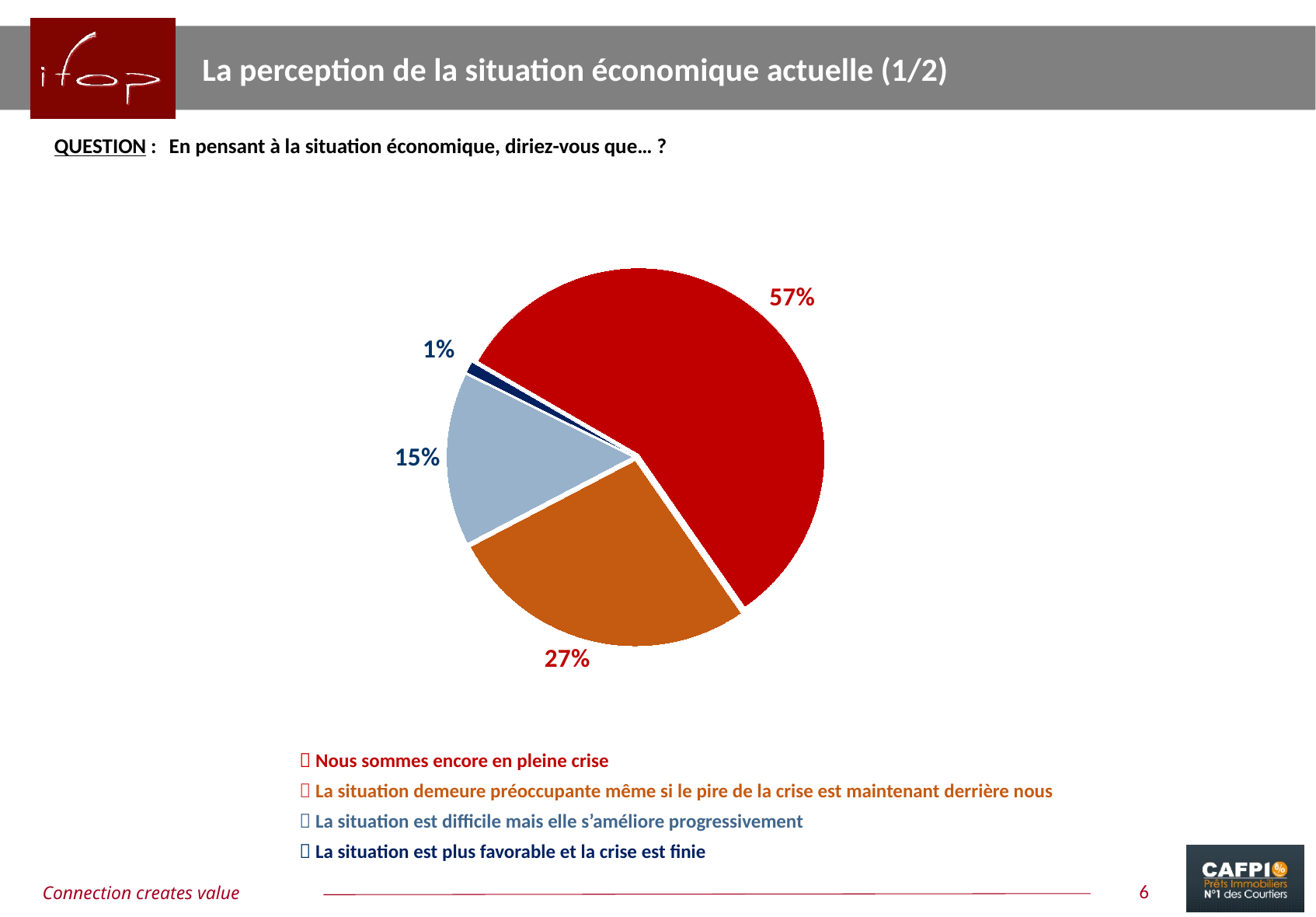
What share of respondents said "La situation demeure préoccupante même si le pire de la crise est maintenant derrière nous"? 27% What share of respondents said "La situation est difficile mais elle s'améliore progressivement"? 15% Which response has the largest slice of the pie? Nous sommes encore en pleine crise How many slices does the pie chart have? 4 Which response has the smallest slice of the pie? La situation est plus favorable et la crise est finie What share of respondents said "Nous sommes encore en pleine crise"? 57% What colour is the slice representing "Nous sommes encore en pleine crise"? red What is the difference in percentage points between "Nous sommes encore en pleine crise" and "La situation demeure préoccupante même si le pire de la crise est maintenant derrière nous"? 30 percentage points Which is larger: the share for "La situation est difficile mais elle s'améliore progressivement" or the share for "La situation demeure préoccupante même si le pire de la crise est maintenant derrière nous"? La situation demeure préoccupante même si le pire de la crise est maintenant derrière nous What kind of chart is shown on the slide? pie chart What share of respondents said "La situation est plus favorable et la crise est finie"? 1% What is the title of the slide containing the pie chart? La perception de la situation économique actuelle (1/2)